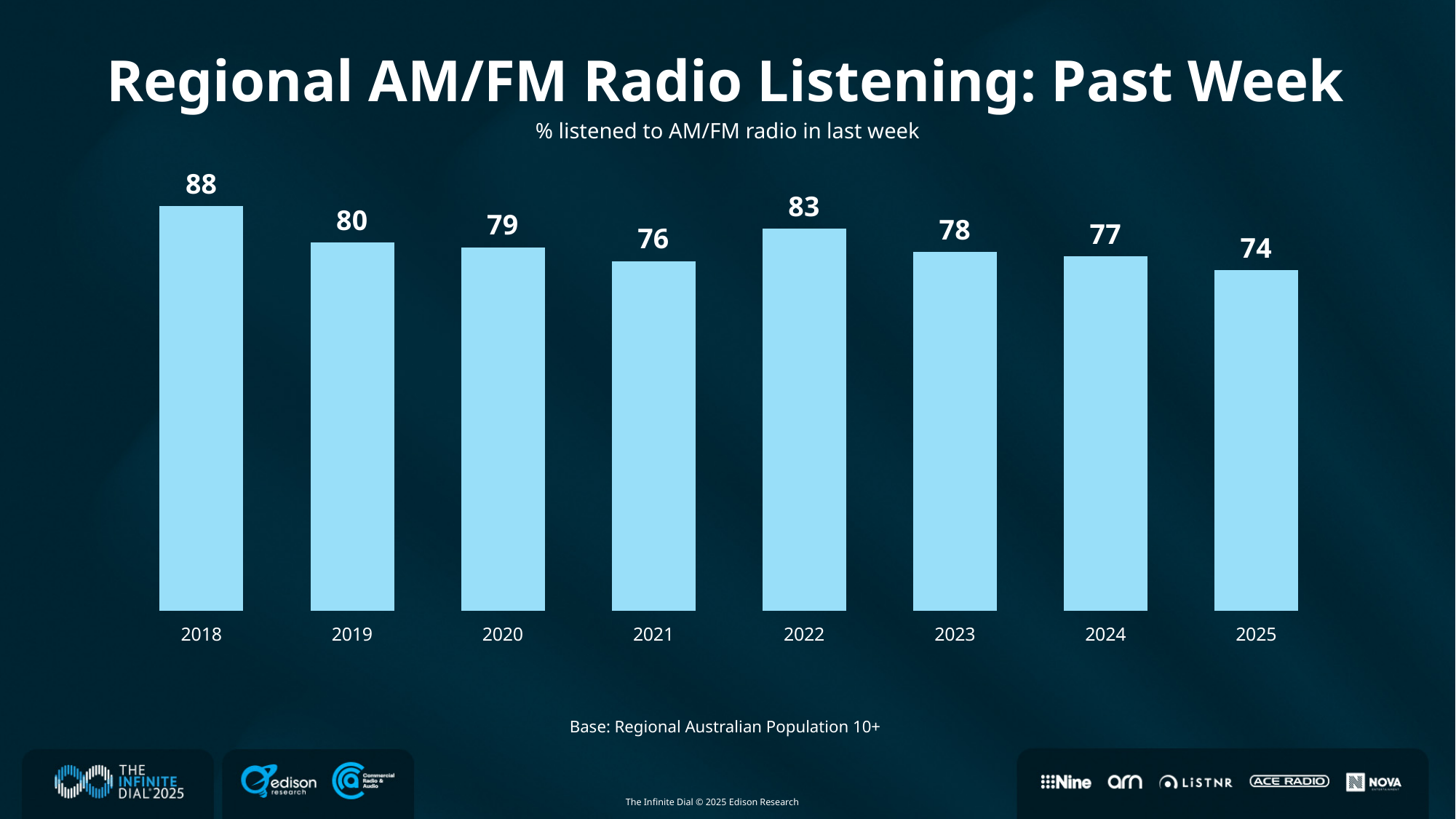
How many years are shown on the chart? 8 What is the difference between the values for 2018 and 2025? 14 What is the title of the chart? Regional AM/FM Radio Listening: Past Week Which year has the highest value? 2018 What is the value for 2018? 88 What kind of chart is this? bar chart Which is larger, the value for 2019 or the value for 2023? 2019 Which year has the lowest value? 2025 What is the difference between the values for 2021 and 2022? 7 What is the value for 2025? 74 What is the value for 2022? 83 Do the values generally rise or fall from 2022 to 2025? fall